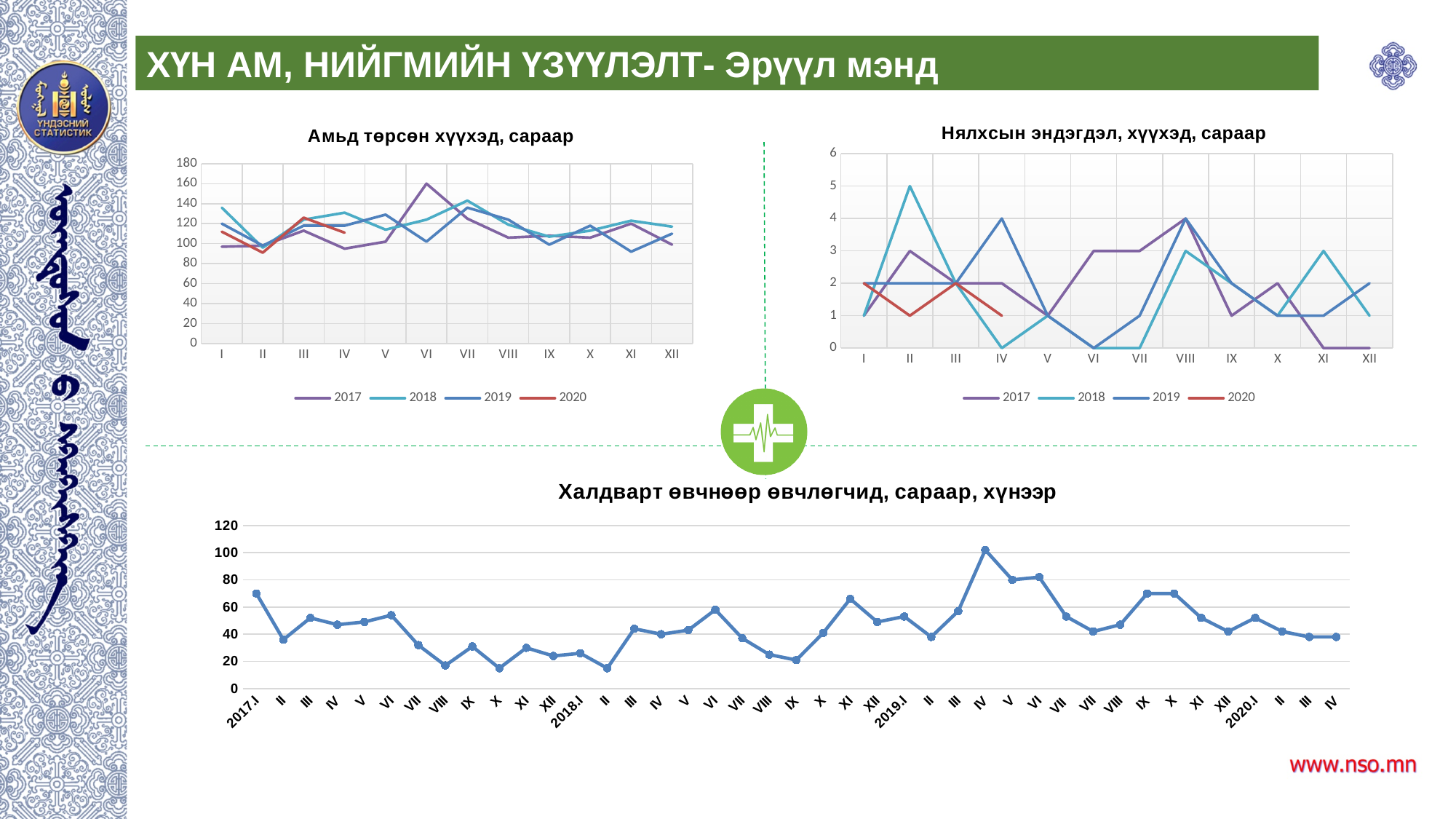
In the chart titled 'Амьд төрсөн хүүхэд, сараар', how many series does the legend list? 4 In the chart titled 'Нялхсын эндэгдэл, хүүхэд, сараар', what is the value for 2018 in month II? 5 In the chart titled 'Нялхсын эндэгдэл, хүүхэд, сараар', which year has the highest value in month II? 2018 In the chart titled 'Халдварт өвчнөөр өвчлөгчид, сараар, хүнээр', which month has the highest value? 2019.IV In the chart titled 'Нялхсын эндэгдэл, хүүхэд, сараар', what is the value for 2020 in month I? 2 In the chart titled 'Амьд төрсөн хүүхэд, сараар', what kind of chart is shown? line chart In the chart titled 'Халдварт өвчнөөр өвчлөгчид, сараар, хүнээр', is the value for 2018.II greater or less than 20? less In the chart titled 'Нялхсын эндэгдэл, хүүхэд, сараар', what is the value for 2018 in month IV? 0 In the chart titled 'Нялхсын эндэгдэл, хүүхэд, сараар', what is the value for 2019 in month IV? 4 In the chart titled 'Халдварт өвчнөөр өвчлөгчид, сараар, хүнээр', what kind of chart is shown? line chart In the chart titled 'Амьд төрсөн хүүхэд, сараар', is the value for 2017 in month VI greater or less than 140? greater In the chart titled 'Амьд төрсөн хүүхэд, сараар', how many months are shown on the x axis? 12